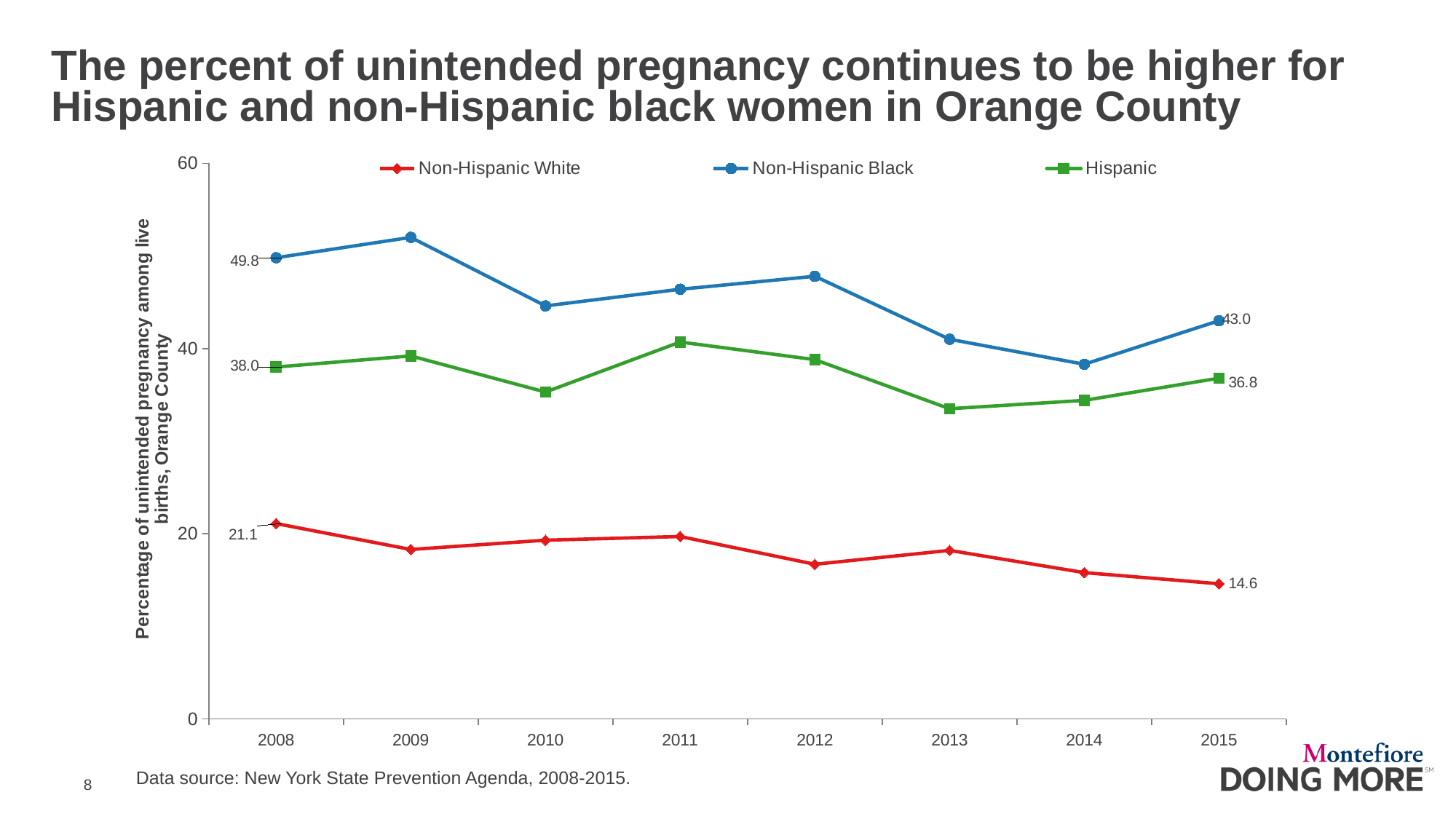
What kind of chart is shown on the slide? Line chart What is the value for Hispanic in 2015? 36.8 How many series does the legend list? 3 Which series has the highest value in 2015? Non-Hispanic Black Is the value for Non-Hispanic Black in 2009 greater or less than 40? greater What is the difference between the Non-Hispanic White value in 2008 and in 2015? 6.5 What is the value for Hispanic in 2008? 38.0 Does the Non-Hispanic White series rise or fall from 2008 to 2015? Fall Which series has the lowest value in 2008? Non-Hispanic White What is the value for Non-Hispanic White in 2015? 14.6 What is the difference between the Non-Hispanic Black value in 2008 and in 2015? 6.8 What is the value for Non-Hispanic Black in 2008? 49.8